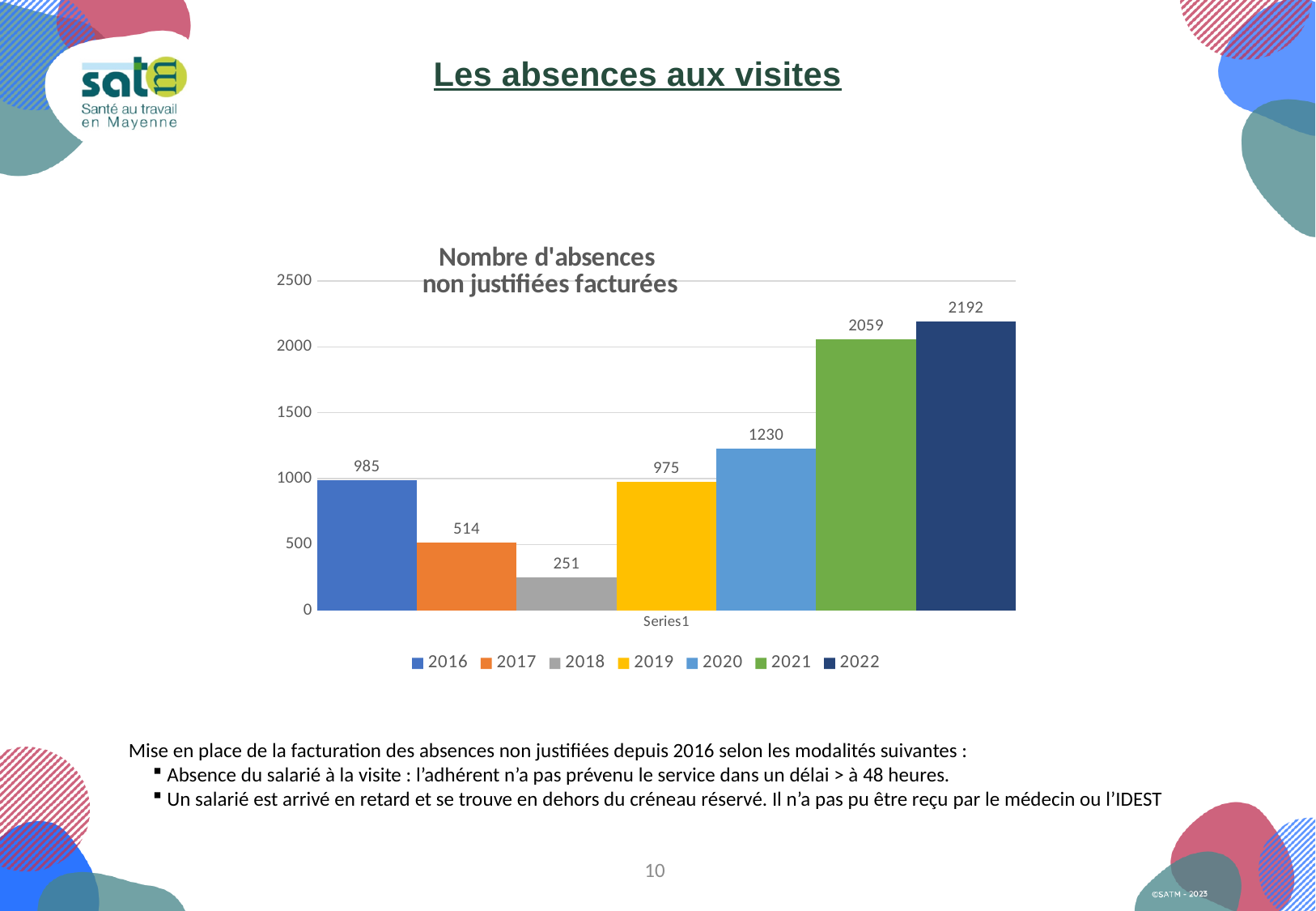
Which year has the lowest number of absences non justifiées facturées? 2018 What is the value for 2016 in the chart? 985 Which year has the highest number of absences non justifiées facturées? 2022 What is the difference between the values for 2022 and 2021? 133 What is the title of the chart? Nombre d'absences non justifiées facturées Which is larger, the value for 2016 or the value for 2019? 2016 How many series does the legend list? 7 What is the value for 2020 in the chart? 1230 What is the value for 2018 in the chart? 251 What is the value for 2022 in the chart? 2192 What kind of chart is shown on the slide? Bar chart What is the difference between the values for 2016 and 2017? 471